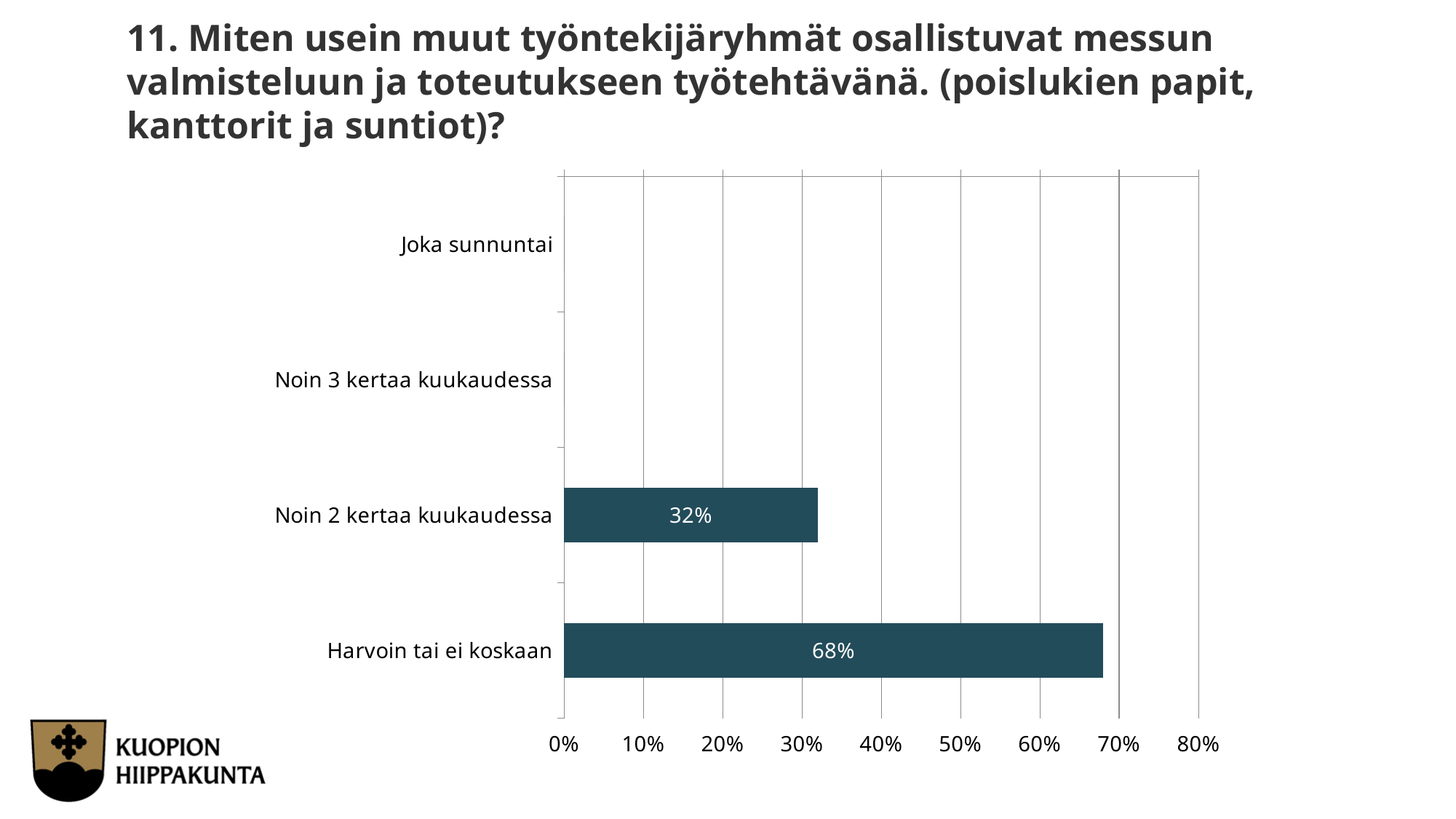
What is the value for "Harvoin tai ei koskaan"? 68% Is the value for "Noin 2 kertaa kuukaudessa" greater or less than 40%? less How many categories are shown on the chart's vertical axis? 4 What is the total of the two labelled bars, "Noin 2 kertaa kuukaudessa" and "Harvoin tai ei koskaan"? 100% What is the highest value shown on the horizontal axis? 80% What is the difference between the values for "Harvoin tai ei koskaan" and "Noin 2 kertaa kuukaudessa"? 36% Is the value for "Harvoin tai ei koskaan" greater or less than 60%? greater Which is larger, the value for "Noin 2 kertaa kuukaudessa" or the value for "Harvoin tai ei koskaan"? Harvoin tai ei koskaan What is the value for "Noin 2 kertaa kuukaudessa"? 32% How many categories have a visible bar with a data label? 2 What kind of chart is shown on the slide? bar chart Which category has the highest value? Harvoin tai ei koskaan